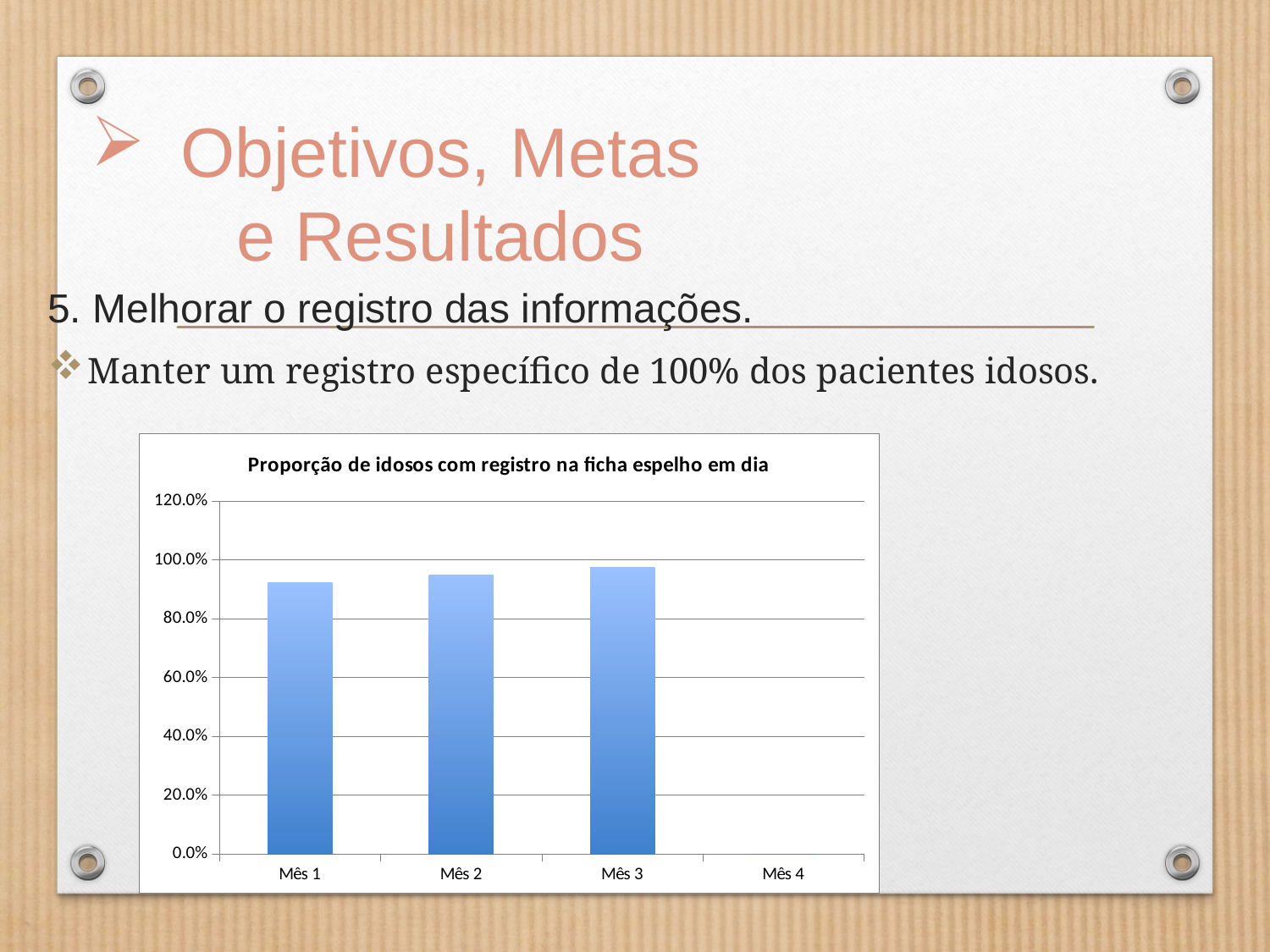
Do the values rise or fall from Mês 1 to Mês 3? rise Is the value for Mês 2 greater or less than 100.0%? less Is the value for Mês 1 greater or less than 80.0%? greater What is the highest value shown on the y axis of the chart? 120.0% How many bars are actually plotted in the chart? 3 How many categories are shown on the x axis of the chart? 4 Which month has the highest bar in the chart? Mês 3 Is the value for Mês 3 greater or less than 100.0%? less What is the title of the chart? Proporção de idosos com registro na ficha espelho em dia What kind of chart is shown on the slide? bar chart Which is larger, the value for Mês 1 or the value for Mês 3? Mês 3 Which category on the x axis has no bar plotted? Mês 4